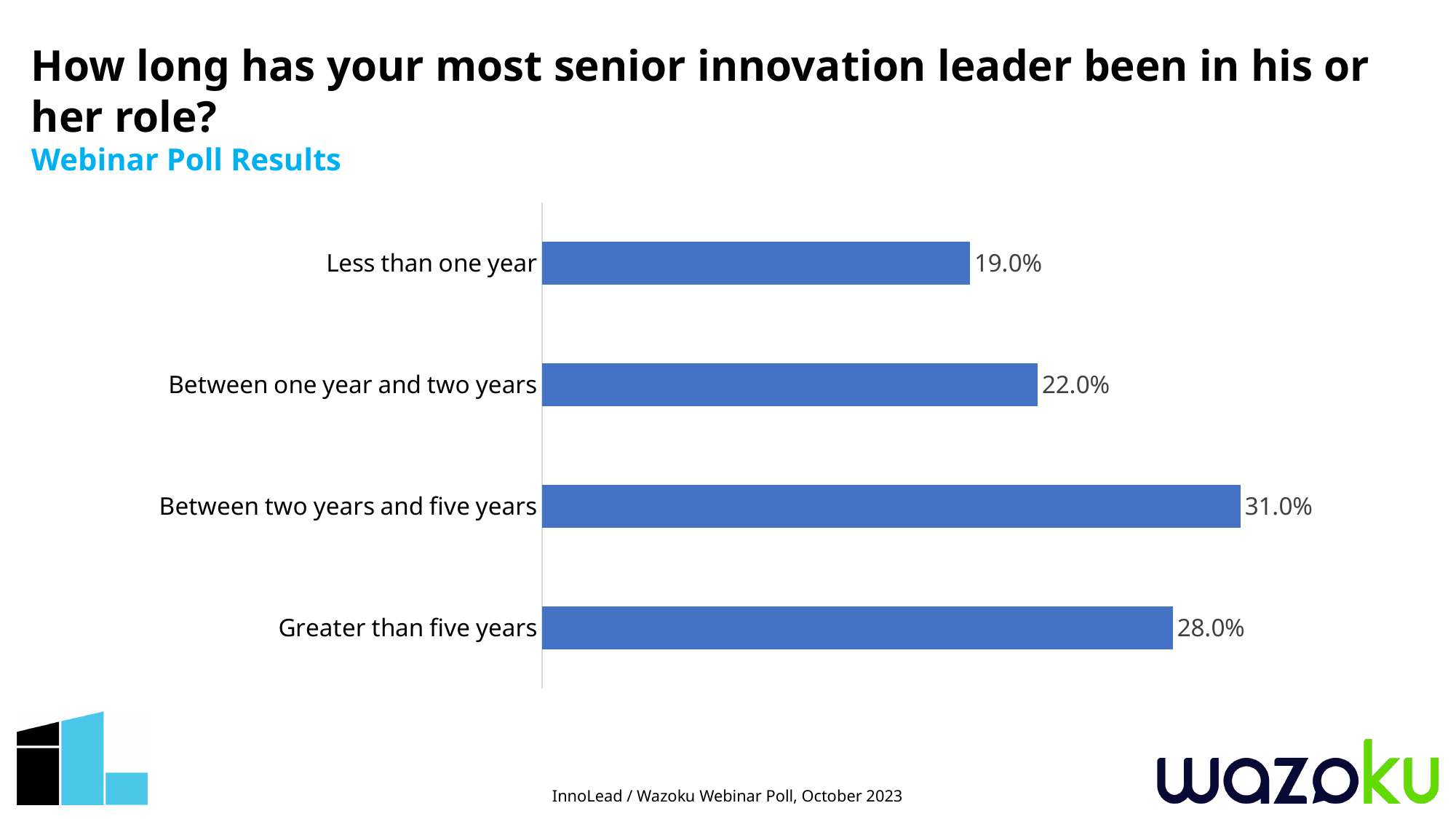
What is the difference between the values for 'Between two years and five years' and 'Greater than five years'? 3.0% What is the value for 'Between one year and two years'? 22.0% What kind of chart is shown on the slide? Bar chart What percentage of respondents said their most senior innovation leader has been in the role for less than one year? 19.0% Which is larger, the value for 'Greater than five years' or the value for 'Between one year and two years'? Greater than five years What is the value for 'Greater than five years'? 28.0% Which category has the highest value? Between two years and five years How many categories are shown in the chart? 4 What is the subtitle shown in blue below the slide title? Webinar Poll Results What is the difference between the values for 'Between one year and two years' and 'Less than one year'? 3.0% What is the value for 'Between two years and five years'? 31.0% Which category has the lowest value? Less than one year